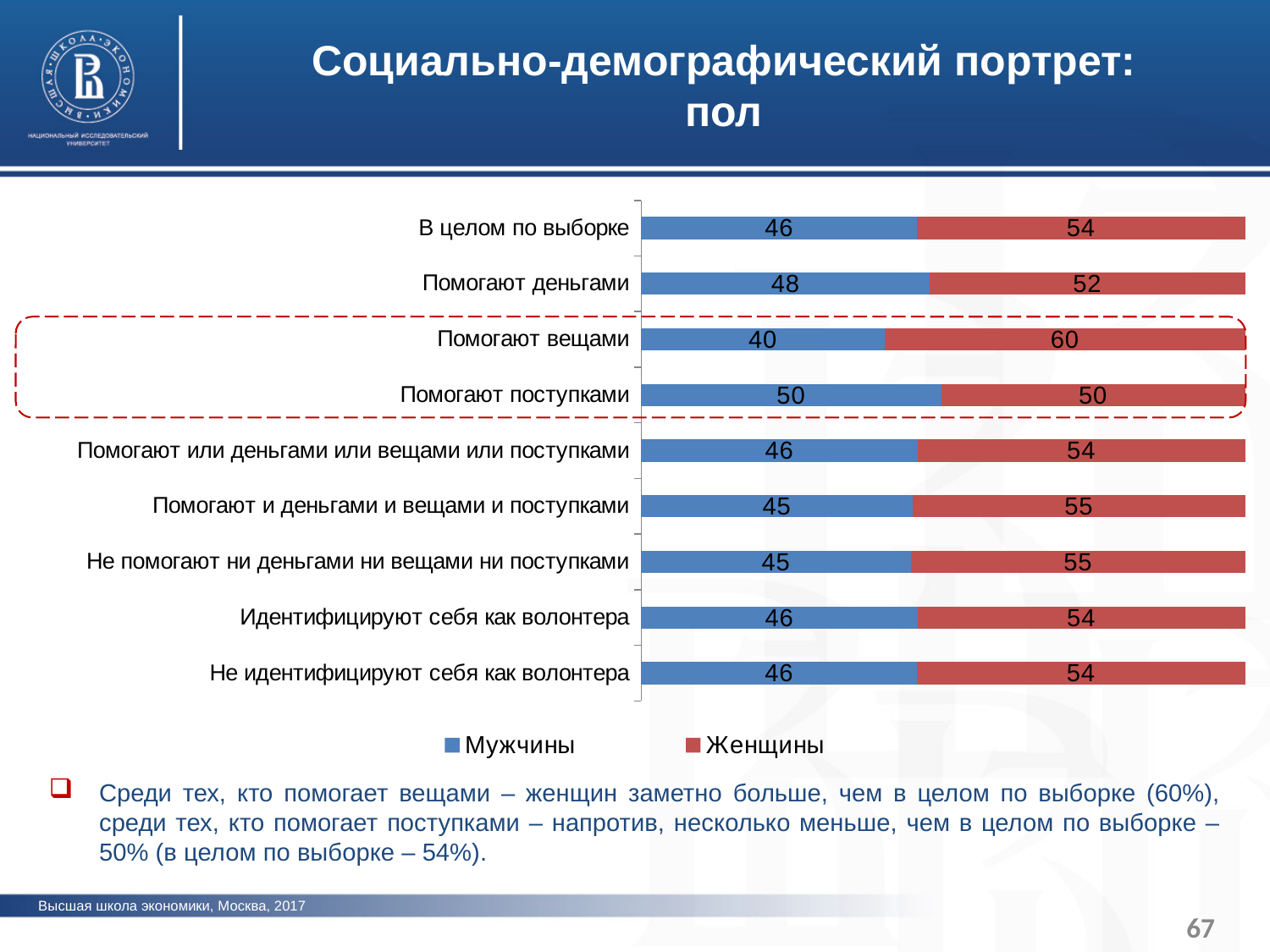
What is the total of the stacked bar for "Помогают вещами"? 100 In the category "Помогают поступками", is the value for Мужчины larger than, smaller than, or equal to the value for Женщины? equal Which category has the highest value for Женщины? Помогают вещами What is the value for Мужчины in the category "Помогают вещами"? 40 What is the difference between the Женщины and Мужчины values in the category "Помогают вещами"? 20 How many categories are shown in the chart? 9 Which is larger: the Мужчины value for "Помогают деньгами" or the Мужчины value for "Помогают и деньгами и вещами и поступками"? Помогают деньгами How many series does the legend list? 2 What is the value for Женщины in the category "Помогают деньгами"? 52 What is the value for Женщины in the category "В целом по выборке"? 54 What kind of chart is shown on the slide? stacked bar chart Which category has the lowest value for Мужчины? Помогают вещами